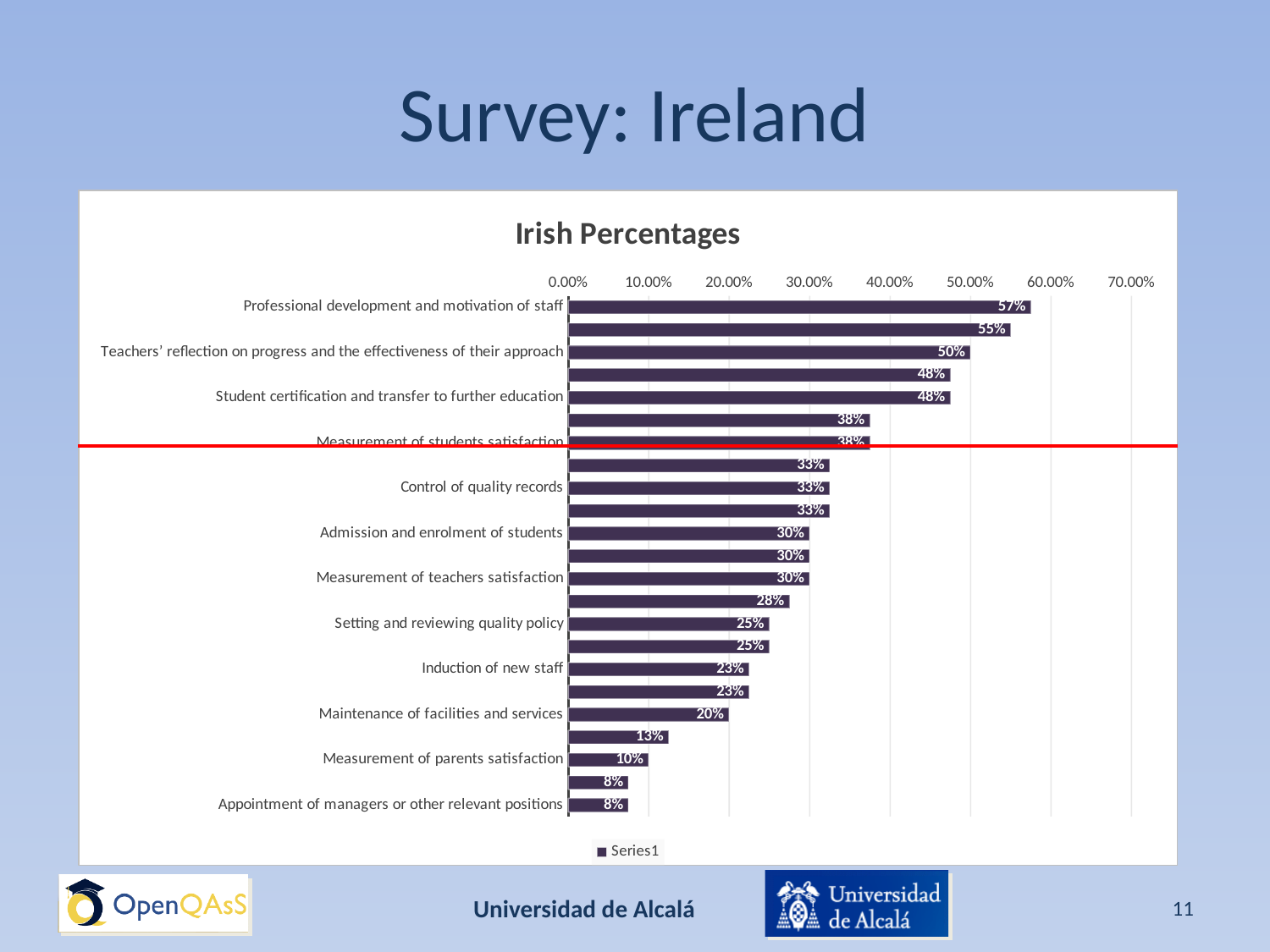
How many bars are plotted on the chart? 23 Which is larger: Setting and reviewing quality policy or Measurement of parents satisfaction? Setting and reviewing quality policy What is the value for Control of quality records? 33% What kind of chart is shown? Bar chart What is the value for Student certification and transfer to further education? 48% What is the difference between Professional development and motivation of staff and Appointment of managers or other relevant positions? 49 percentage points Which category has the highest value? Professional development and motivation of staff What is the value for Maintenance of facilities and services? 20% What is the lowest value shown on the chart? 8% What is the value for Appointment of managers or other relevant positions? 8% Is the value for Teachers' reflection on progress and the effectiveness of their approach greater or less than 40.00%? greater What is the value for Professional development and motivation of staff? 57%